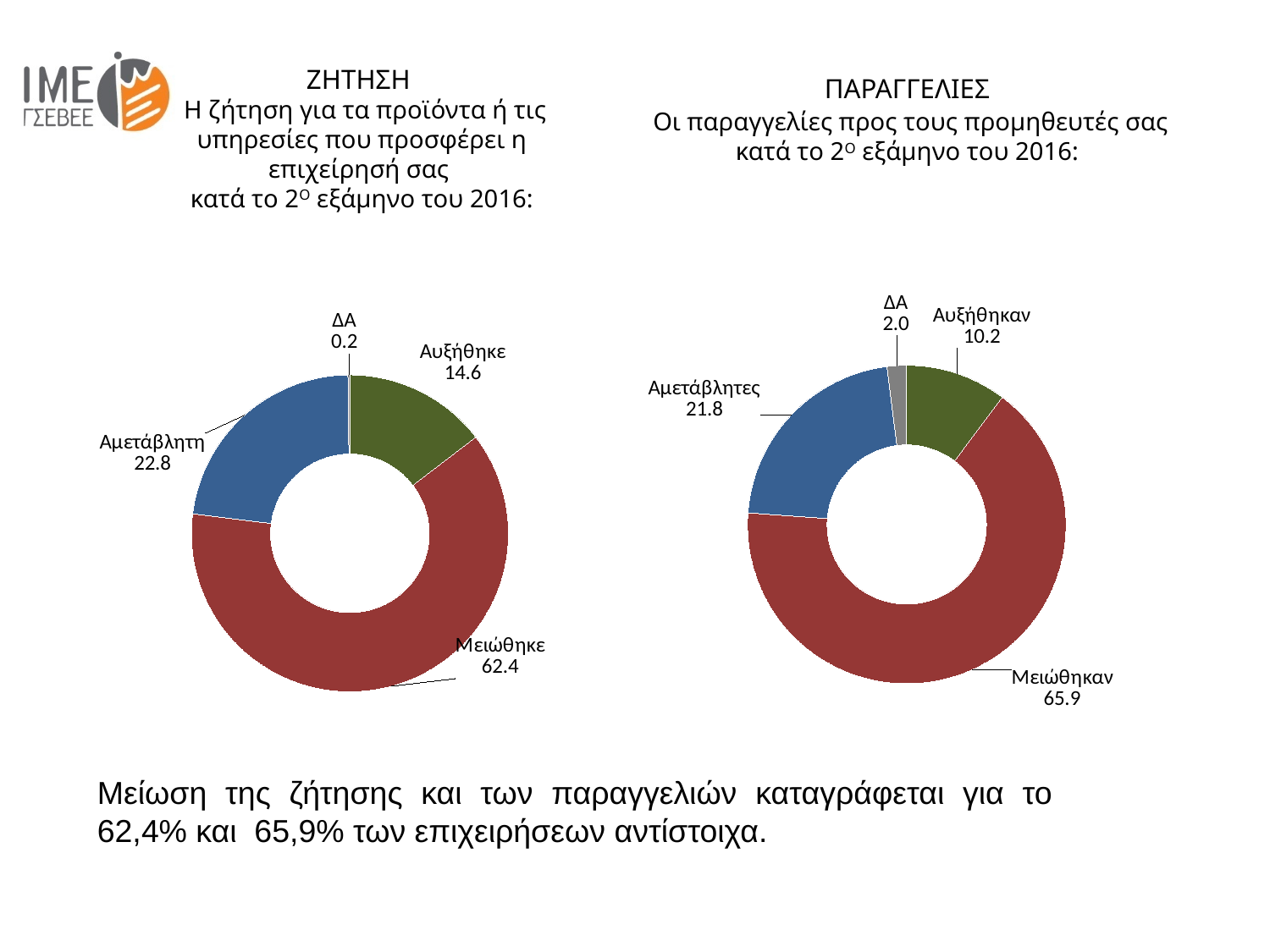
In the left chart (ΖΗΤΗΣΗ), which category has the largest value? Μειώθηκε In the right chart (ΠΑΡΑΓΓΕΛΙΕΣ), what is the value for Αμετάβλητες? 21.8 How many categories does the left chart (ΖΗΤΗΣΗ) show? 4 In the right chart (ΠΑΡΑΓΓΕΛΙΕΣ), which category has the smallest value? ΔΑ In the right chart (ΠΑΡΑΓΓΕΛΙΕΣ), what is the value for Αυξήθηκαν? 10.2 In the left chart (ΖΗΤΗΣΗ), what is the difference between Αμετάβλητη and Αυξήθηκε? 8.2 In the left chart (ΖΗΤΗΣΗ), what is the value for Μειώθηκε? 62.4 In the right chart (ΠΑΡΑΓΓΕΛΙΕΣ), what is the difference between Μειώθηκαν and Αμετάβλητες? 44.1 In the left chart (ΖΗΤΗΣΗ), what is the value for ΔΑ? 0.2 Which is larger: Μειώθηκε in the left chart (ΖΗΤΗΣΗ) or Μειώθηκαν in the right chart (ΠΑΡΑΓΓΕΛΙΕΣ)? Μειώθηκαν in the right chart What kind of chart is the right chart (ΠΑΡΑΓΓΕΛΙΕΣ)? Doughnut chart What colour is the Μειώθηκε segment in the left chart (ΖΗΤΗΣΗ)? Red